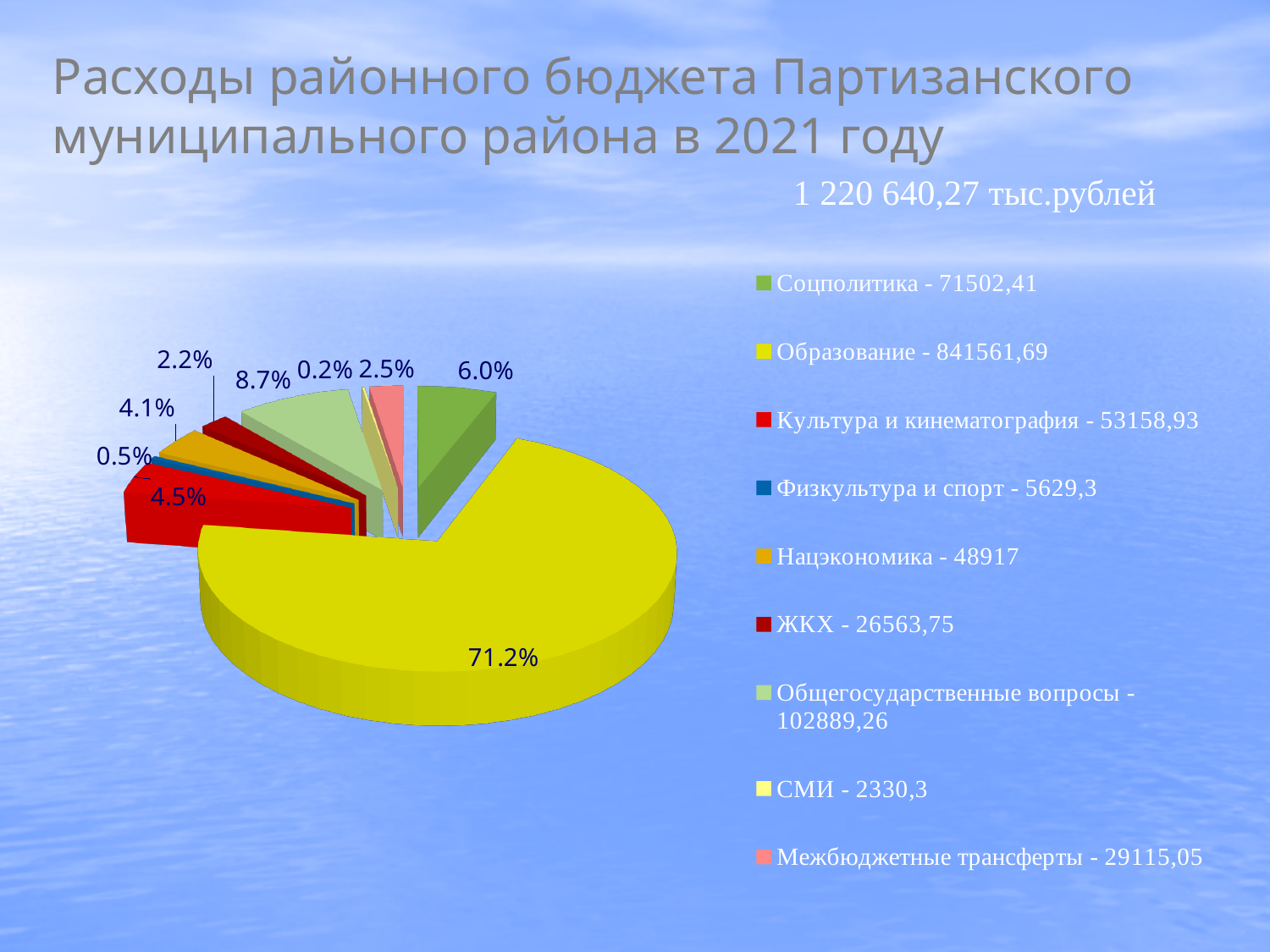
What is the difference between the percentage shares of Соцполитика and Культура и кинематография? 1.5% What kind of chart is shown on the slide? pie chart What value is given for Нацэкономика in the legend? 48917 Which category has the smallest share of the pie? СМИ Which is larger, the value for Культура и кинематография or the value for ЖКХ? Культура и кинематография What value is given for Физкультура и спорт in the legend? 5629,3 What total amount in тыс.рублей is stated above the legend? 1 220 640,27 тыс.рублей What share of the pie does Общегосударственные вопросы take? 8.7% Which category has the largest share of the pie? Образование What share of the pie does Образование take? 71.2% What share of the pie does Соцполитика take? 6.0% How many categories does the pie chart have? 9